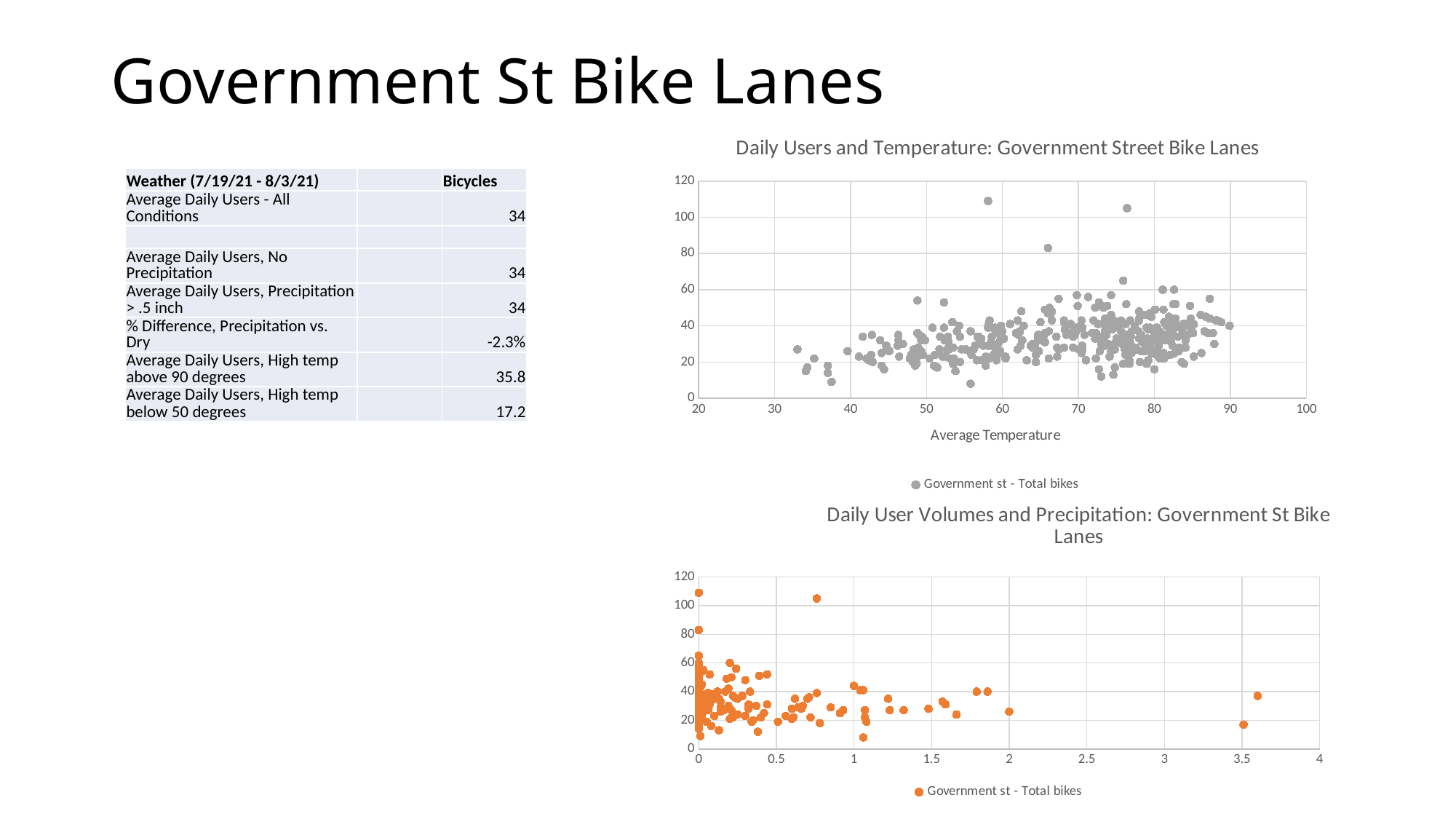
In the bottom chart, is the value for the point at precipitation 3.5 greater or less than 40? less What kind of chart is the top chart, 'Daily Users and Temperature: Government Street Bike Lanes'? Scatter chart In the top chart, what is the maximum value shown on the y axis? 120 What kind of chart is the bottom chart, 'Daily User Volumes and Precipitation: Government St Bike Lanes'? Scatter chart In the bottom chart, how many series does the legend list? 1 In the bottom chart, is the highest plotted value greater or less than 100? greater In the bottom chart, is the value for the point at precipitation 2 greater or less than 40? less In the top chart, how many series does the legend list? 1 In the top chart, what is the title of the x axis? Average Temperature In the bottom chart, what is the legend entry for the plotted series? Government st - Total bikes